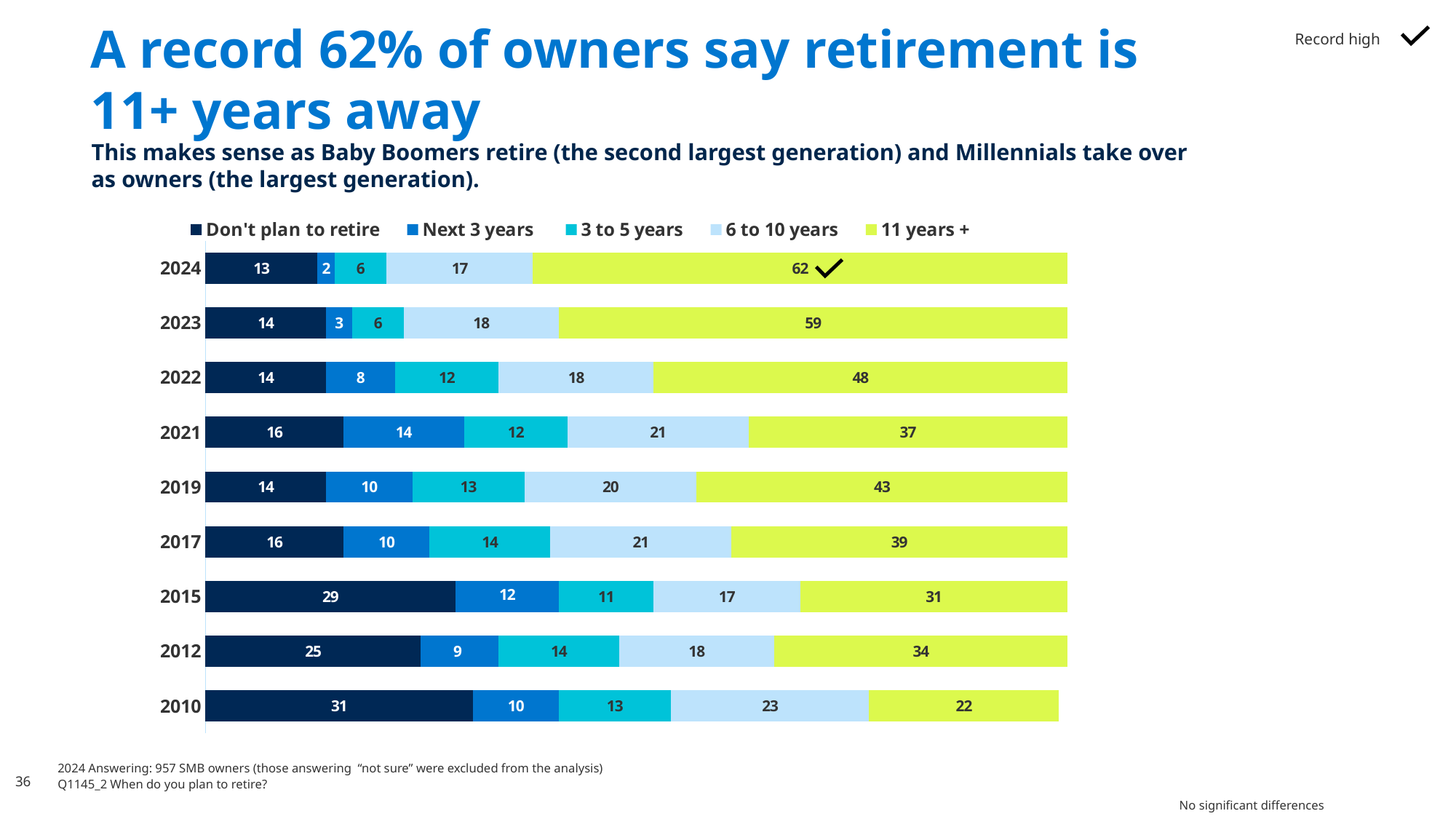
What is the value for "11 years +" in 2024? 62 Which year has the lowest value for "Next 3 years"? 2024 What is the value for "6 to 10 years" in 2021? 21 Which year has the highest value for "11 years +"? 2024 What is the difference between the "11 years +" values for 2024 and 2023? 3 What is the value for "Don't plan to retire" in 2010? 31 Which legend entry is shown in light green? 11 years + What kind of chart is shown on the slide? Stacked bar chart How many series does the legend list? 5 What is the total of the stacked bar for 2010? 99 How many years are shown on the chart? 9 Which is larger: "Don't plan to retire" in 2015 or in 2012? 2015